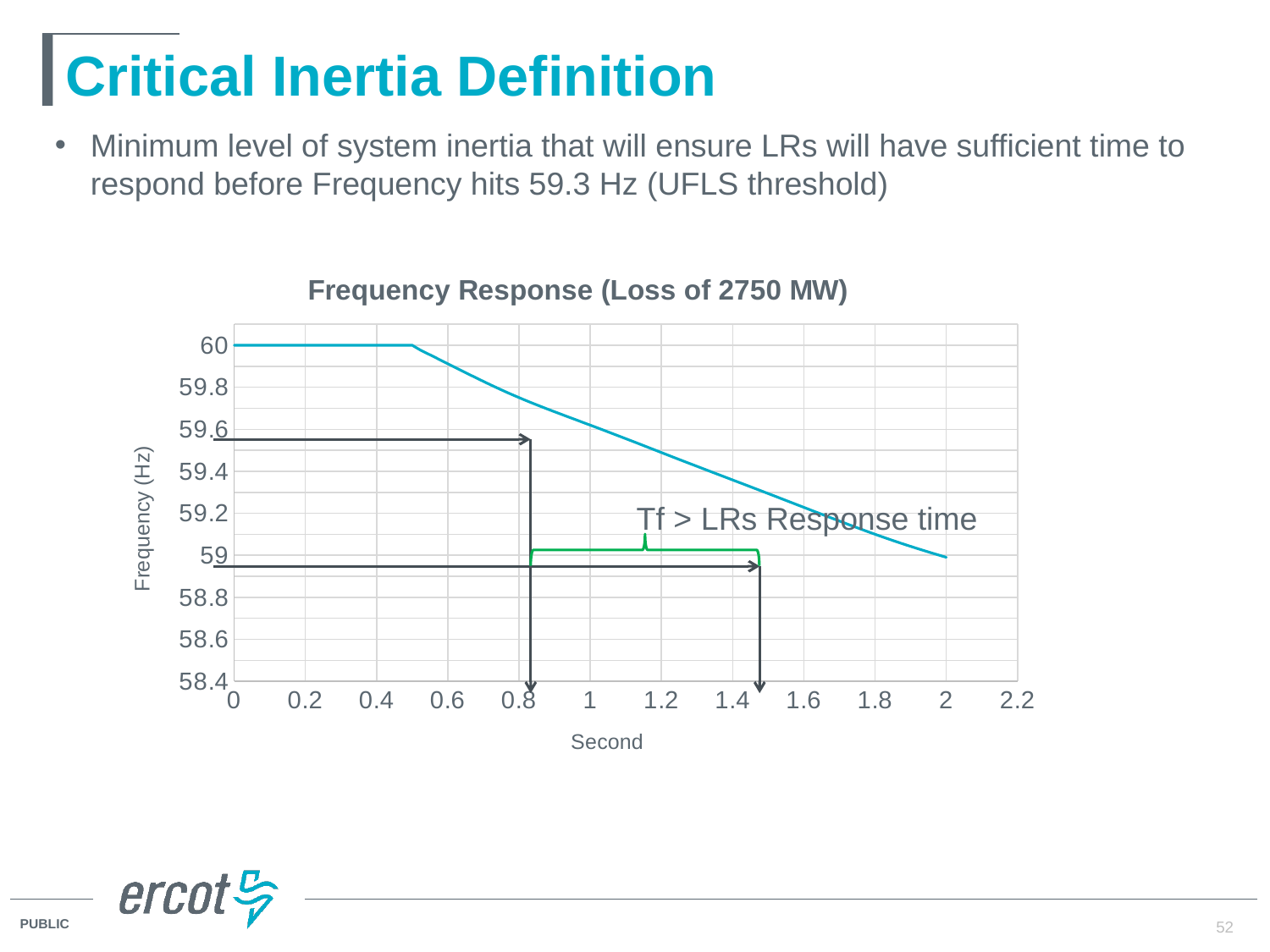
What kind of chart is shown on the slide? line chart What is the frequency value at 0 seconds? 60 Is the frequency at 2 seconds greater or less than 59.2? less Which is larger, the frequency at 0.6 seconds or the frequency at 1.8 seconds? 0.6 seconds How many tick labels are shown on the x axis? 12 What text annotation is written above the green bracket on the chart? Tf > LRs Response time Is the frequency at 1.5 seconds greater or less than 59.4? less Does the frequency rise or fall along the x axis after 0.5 seconds? fall What is the highest frequency value plotted on the chart? 60 Is the frequency at 1 second greater or less than 59.4? greater What is the title of the chart? Frequency Response (Loss of 2750 MW)